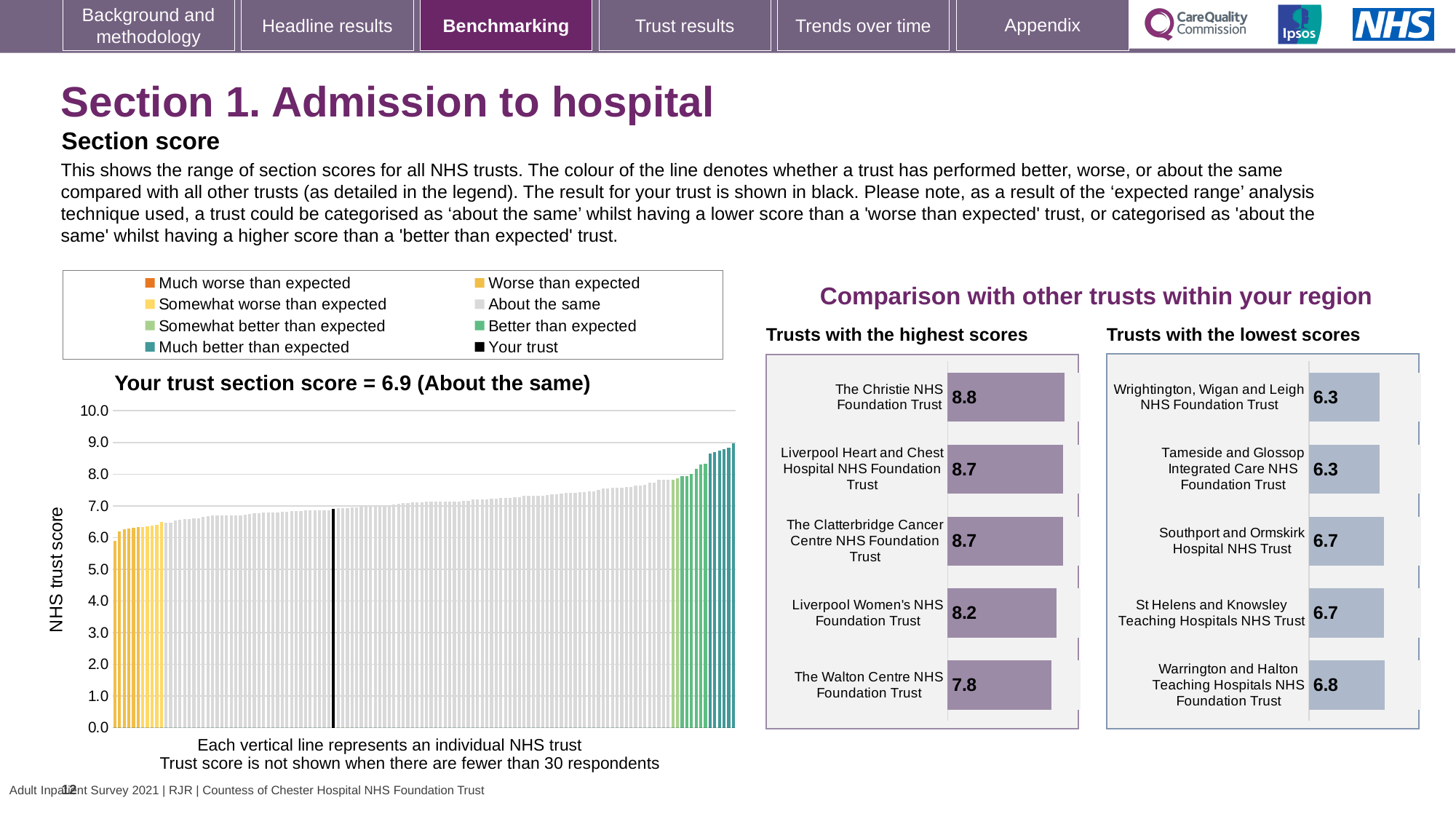
How many entries does the legend above the 'Your trust section score' chart list? 8 What kind of chart is 'Your trust section score'? bar chart In the chart 'Your trust section score', do the bars rise or fall from left to right? rise In the chart 'Your trust section score', what is the section score for your trust? 6.9 In the chart 'Your trust section score', is the value for your trust greater or less than 5.0? greater In the chart 'Trusts with the highest scores', what is the score for The Christie NHS Foundation Trust? 8.8 In the chart 'Trusts with the highest scores', what is the difference between The Christie NHS Foundation Trust and The Walton Centre NHS Foundation Trust? 1.0 In the chart 'Trusts with the lowest scores', what is the score for Southport and Ormskirk Hospital NHS Trust? 6.7 In the chart 'Trusts with the lowest scores', how many trusts are shown? 5 In the chart 'Your trust section score', what category is your trust placed in? About the same In the chart 'Trusts with the lowest scores', which is larger: the score for Warrington and Halton Teaching Hospitals NHS Foundation Trust or Wrightington, Wigan and Leigh NHS Foundation Trust? Warrington and Halton Teaching Hospitals NHS Foundation Trust In the chart 'Trusts with the highest scores', which trust has the lowest score? The Walton Centre NHS Foundation Trust